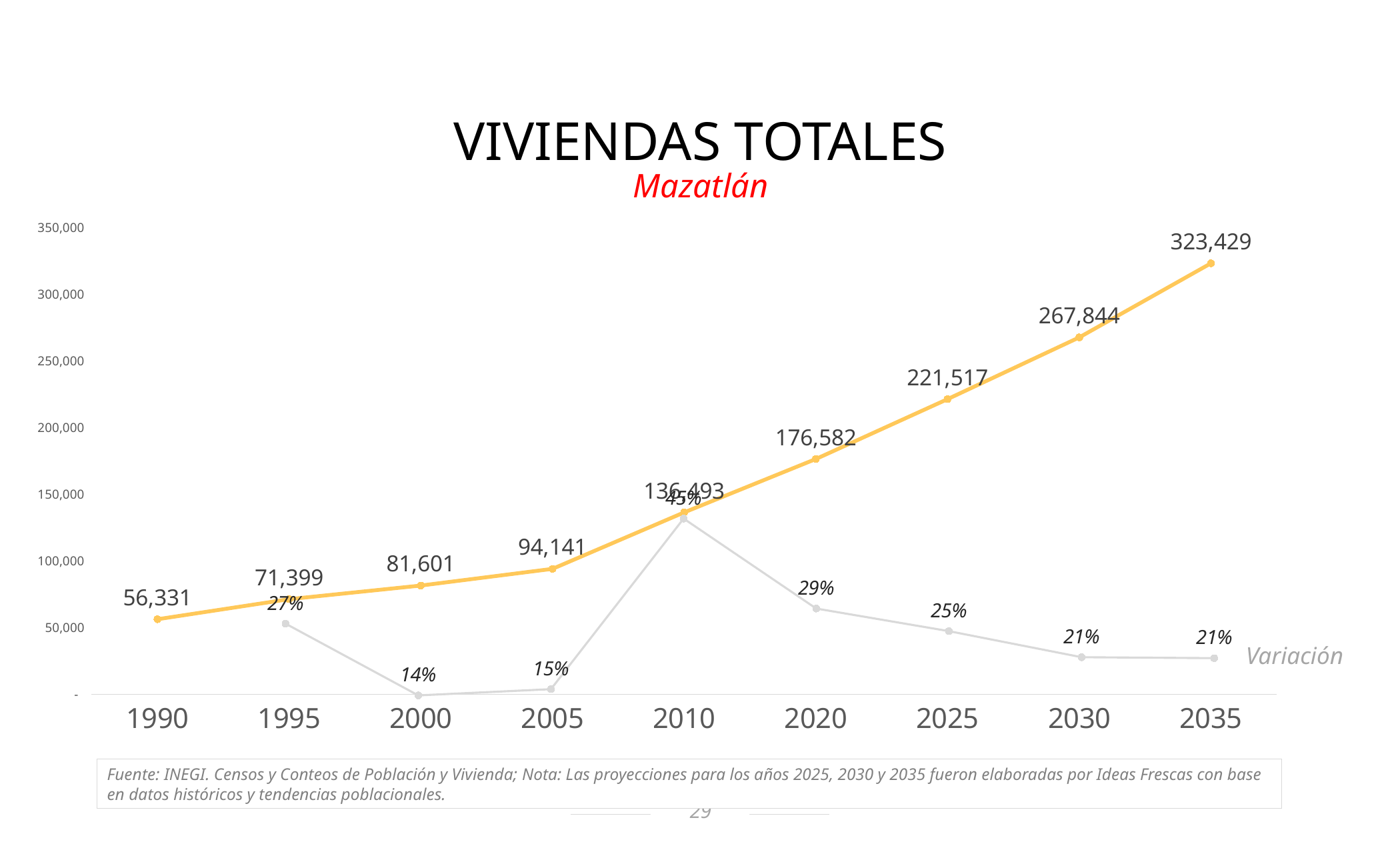
What is the Variación value shown for 2025? 25% What is the value of Viviendas Totales for 2035? 323,429 How many years are shown on the x axis of the chart? 9 What is the value of Viviendas Totales for 1990? 56,331 Which year has the lowest value of Viviendas Totales? 1990 Which year has the highest value of Viviendas Totales? 2035 What is the value of Viviendas Totales for 2020? 176,582 Do the Viviendas Totales values rise or fall from 1990 to 2035? Rise What is the Variación value shown for 2000? 14% What kind of chart is shown on the slide? Line chart Which year has a larger Viviendas Totales value, 2000 or 2005? 2005 What is the difference between the Viviendas Totales values for 2030 and 2025? 46,327